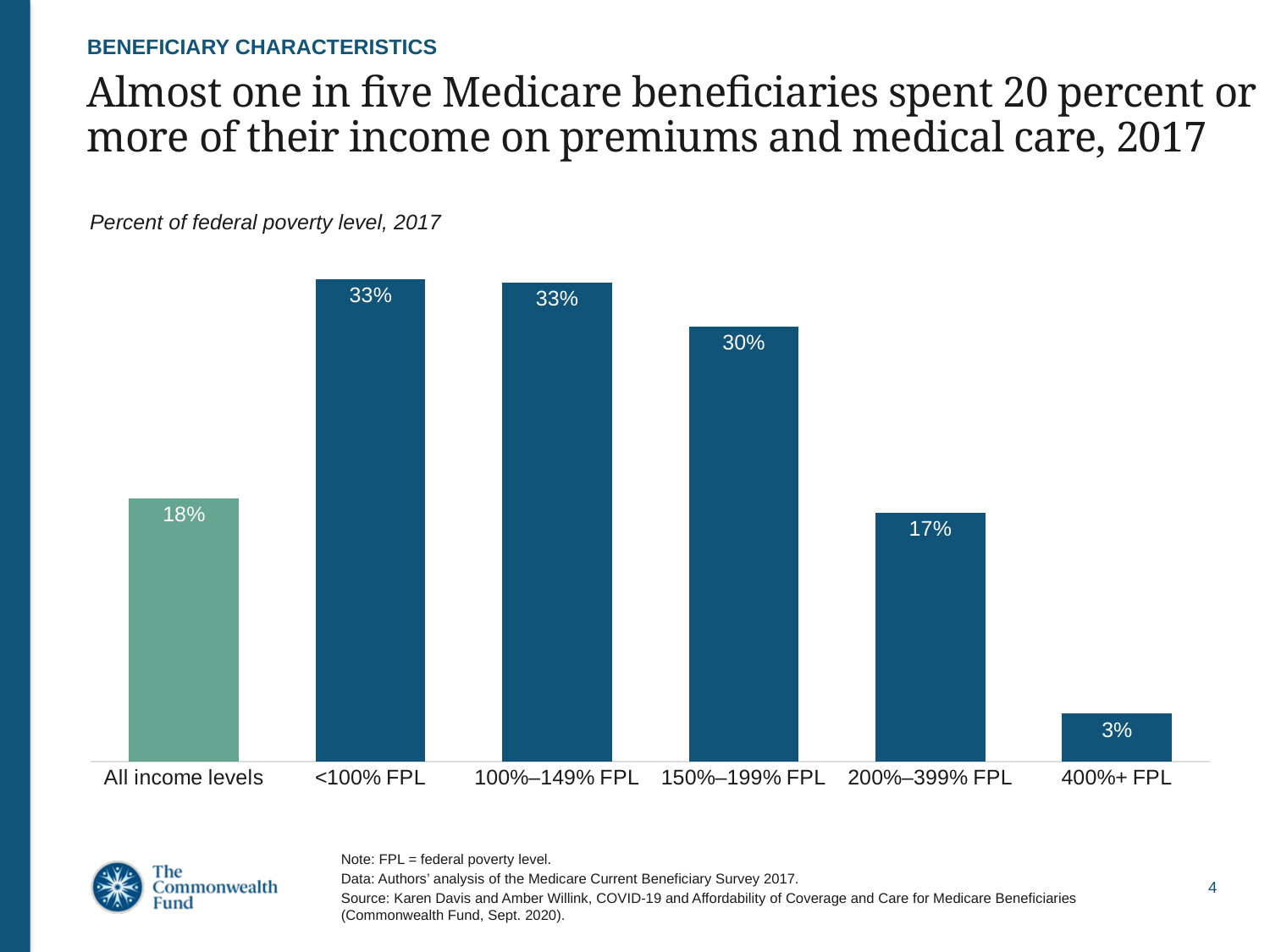
What kind of chart is shown on the slide? Bar chart What is the value for All income levels? 18% Which category has the lowest value? 400%+ FPL What is the value for 150%–199% FPL? 30% Which is larger, the value for 150%–199% FPL or the value for 100%–149% FPL? 100%–149% FPL Which bar is shown in a different colour from the others? All income levels Which is larger, the value for All income levels or the value for 200%–399% FPL? All income levels How many categories are shown on the x axis? 6 What is the value for 400%+ FPL? 3% What is the value for 200%–399% FPL? 17% What is the difference between the values for 150%–199% FPL and 400%+ FPL? 27 percentage points What is the difference between the values for <100% FPL and 200%–399% FPL? 16 percentage points